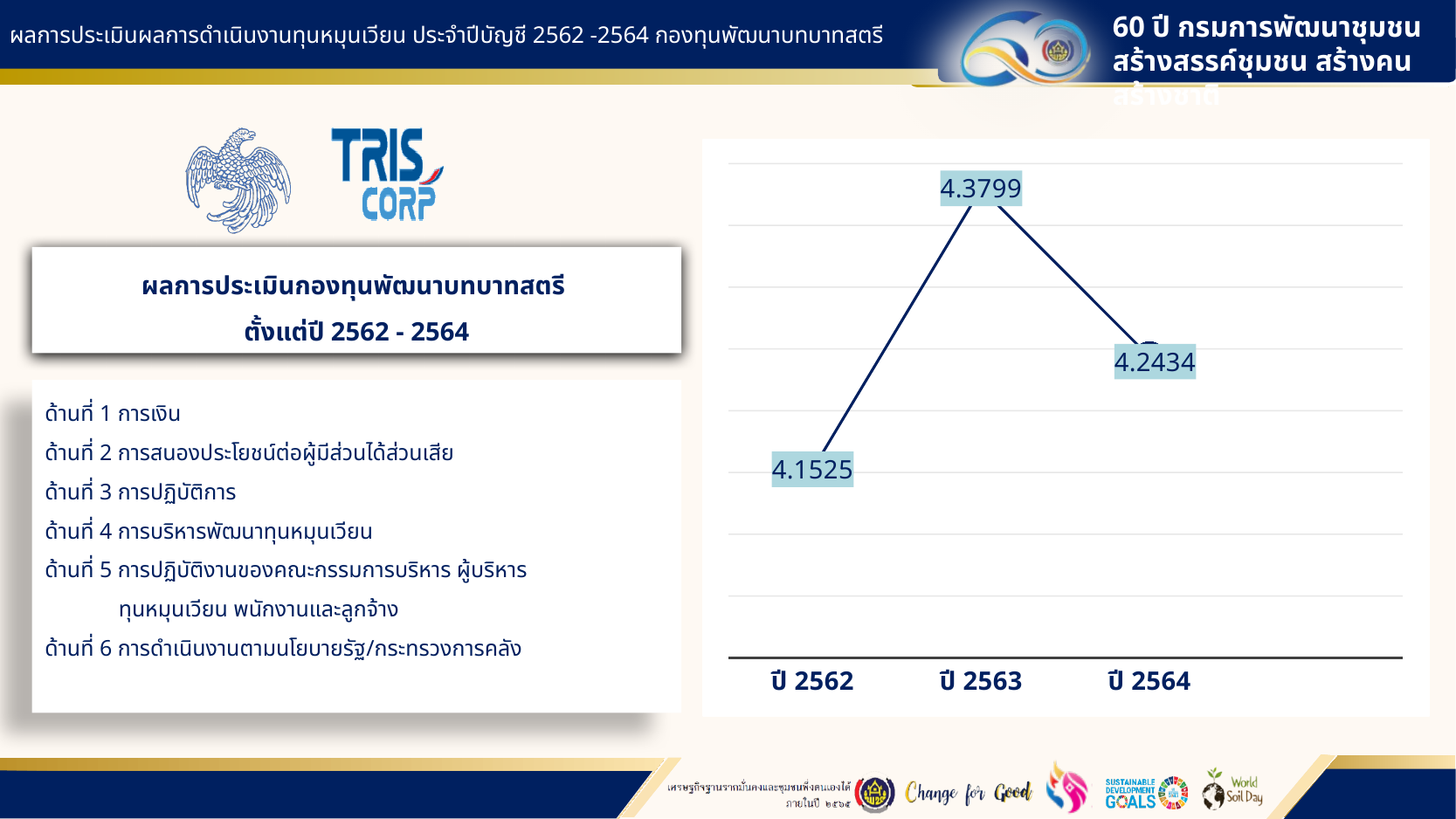
Does the value rise or fall from ปี 2562 to ปี 2563? rise Which year has the lowest value? ปี 2562 What is the value for ปี 2564? 4.2434 What kind of chart is shown on the slide? line chart What is the value for ปี 2563? 4.3799 What is the difference between the values for ปี 2563 and ปี 2564? 0.1365 Which year has the highest value? ปี 2563 Which is larger, the value for ปี 2564 or the value for ปี 2562? ปี 2564 What is the value for ปี 2562? 4.1525 What is the difference between the values for ปี 2563 and ปี 2562? 0.2274 How many data points are plotted on the chart? 3 Does the value rise or fall from ปี 2563 to ปี 2564? fall